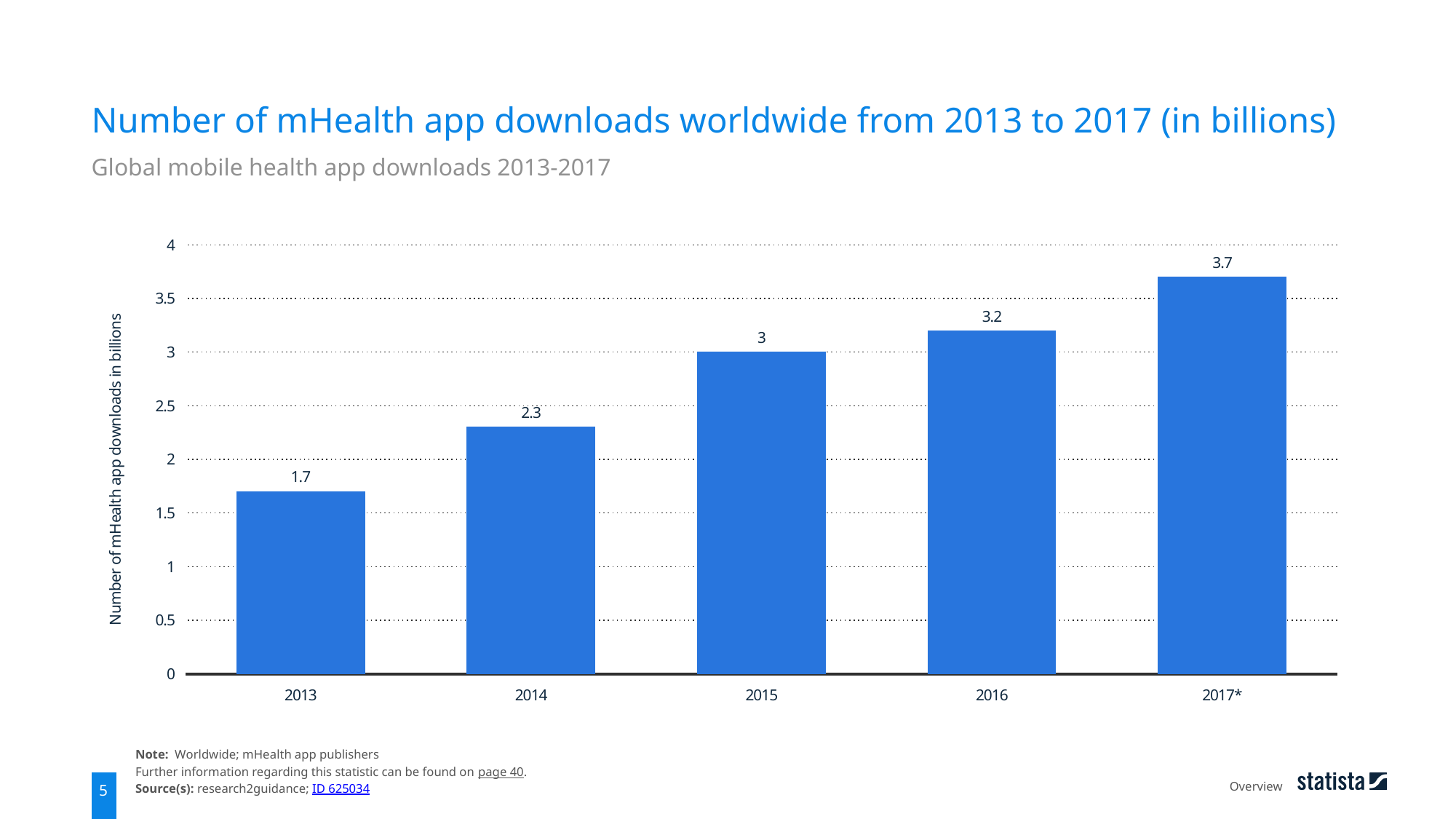
Which year has more mHealth app downloads, 2014 or 2016? 2016 What is the label of the y axis? Number of mHealth app downloads in billions What is the number of mHealth app downloads in 2015? 3 Which year has the highest number of mHealth app downloads? 2017* Is the value for 2015 greater or less than 2.5? greater Do the values rise or fall from 2013 to 2017*? Rise Which year has the lowest number of mHealth app downloads? 2013 What is the number of mHealth app downloads in 2013? 1.7 What kind of chart is shown on the slide? Bar chart What is the number of mHealth app downloads in 2017*? 3.7 How many years are shown on the x axis? 5 What is the difference in mHealth app downloads between 2016 and 2014? 0.9